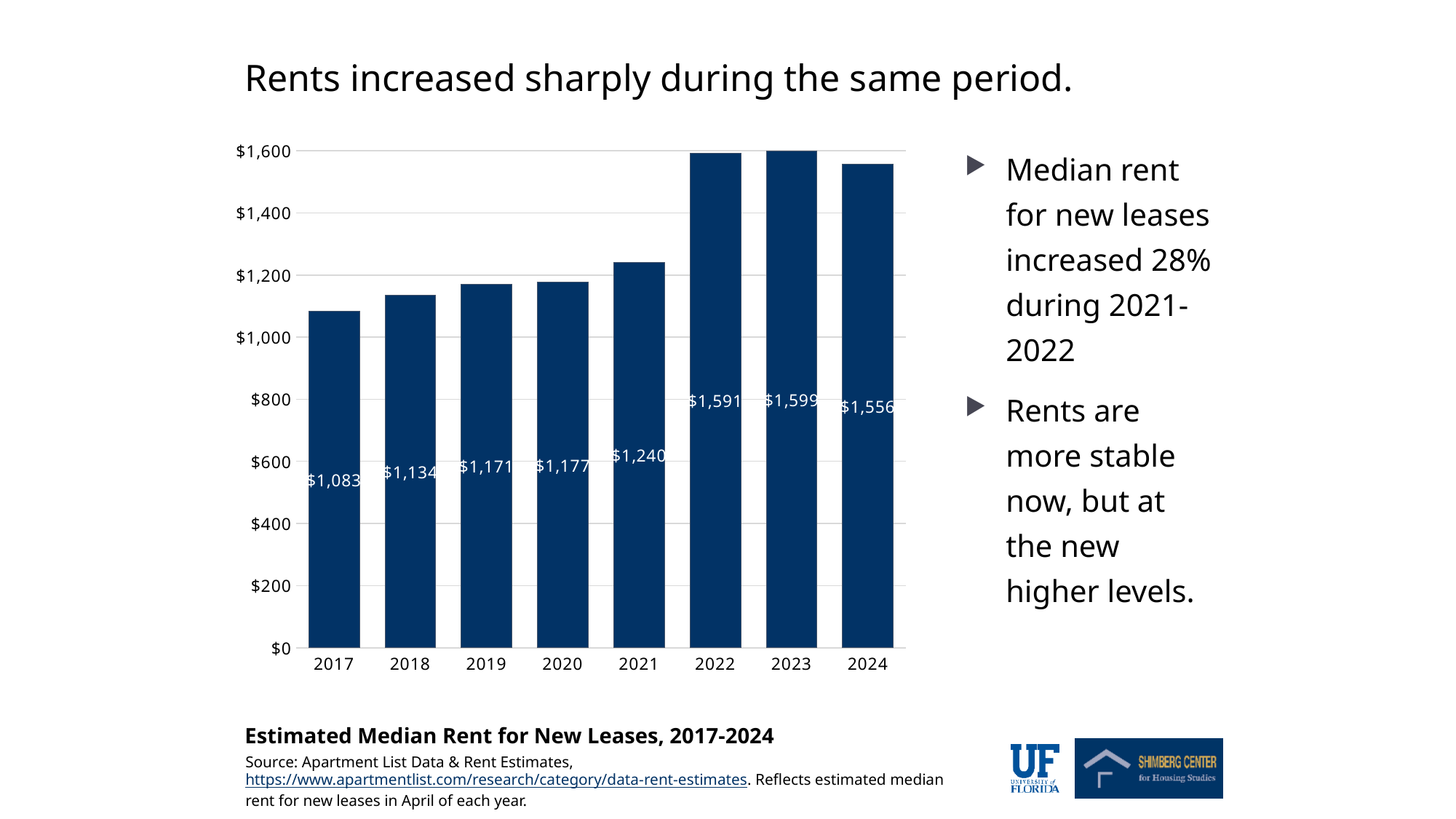
Do the median rent values generally rise or fall from 2017 to 2023? Rise What is the estimated median rent for new leases in 2024? $1,556 What is the difference between the median rent in 2022 and in 2021? $351 How many years are shown on the chart? 8 Is the value for 2021 greater or less than $1,400? less Which year has the lowest estimated median rent? 2017 What is the estimated median rent for new leases in 2022? $1,591 Which year has a higher median rent, 2020 or 2024? 2024 What is the title of the chart? Estimated Median Rent for New Leases, 2017-2024 What is the estimated median rent for new leases in 2017? $1,083 What kind of chart is shown on the slide? Bar chart Which year has the highest estimated median rent? 2023